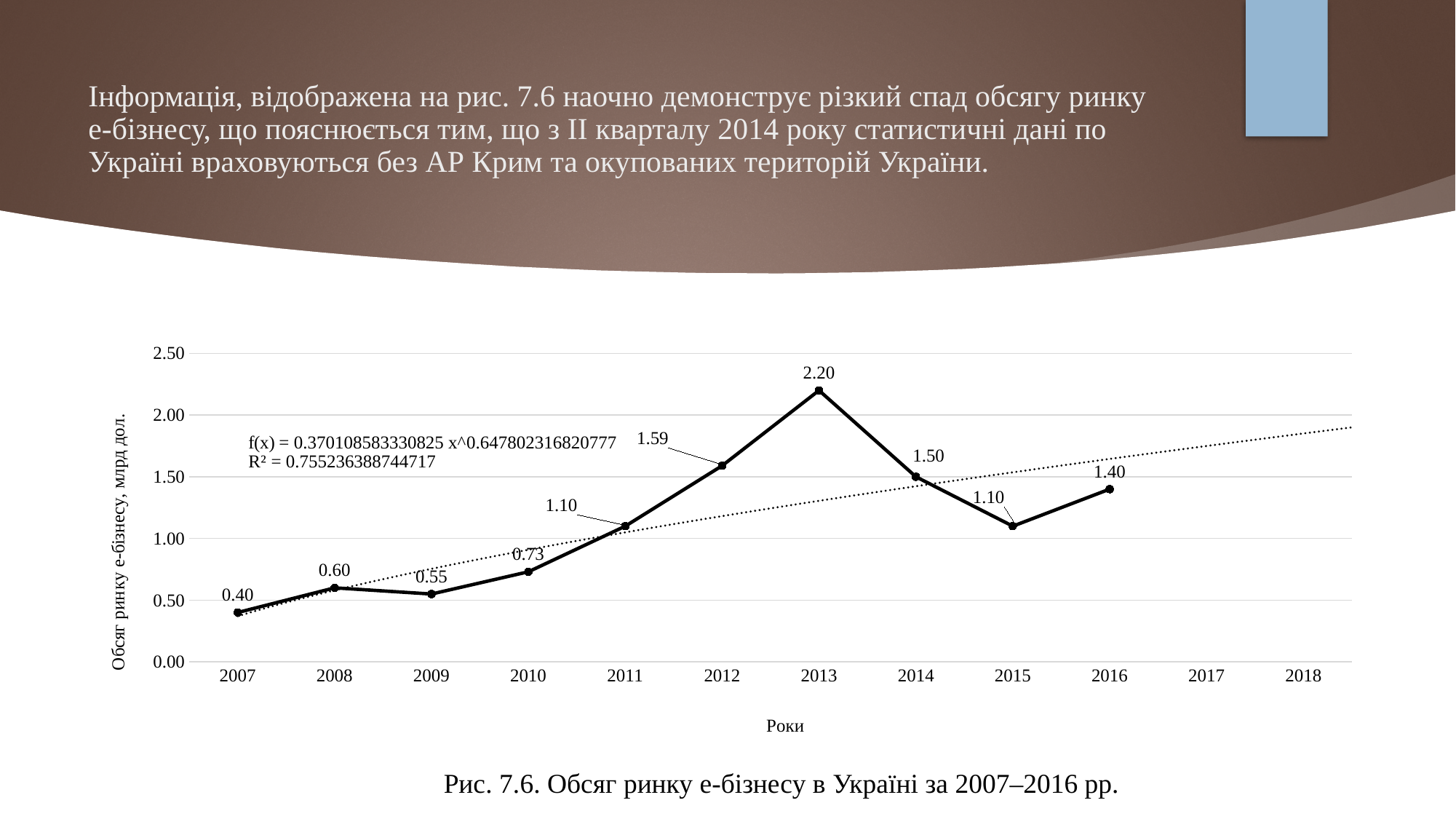
Which year has the lowest e-business market volume? 2007 What is the difference between the values for 2013 and 2014? 0.70 What is the value plotted for 2007? 0.40 Do the values rise or fall from 2013 to 2015? fall What type of chart is shown on the slide? line chart What is the label of the vertical axis? Обсяг ринку е-бізнесу, млрд дол. Is the value for 2016 greater or less than 1.50? less What is the e-business market volume for 2013? 2.20 What is the value plotted for 2012? 1.59 Which year has a larger value, 2009 or 2010? 2010 Which year has the highest e-business market volume? 2013 How many years have a plotted data point on the chart? 10